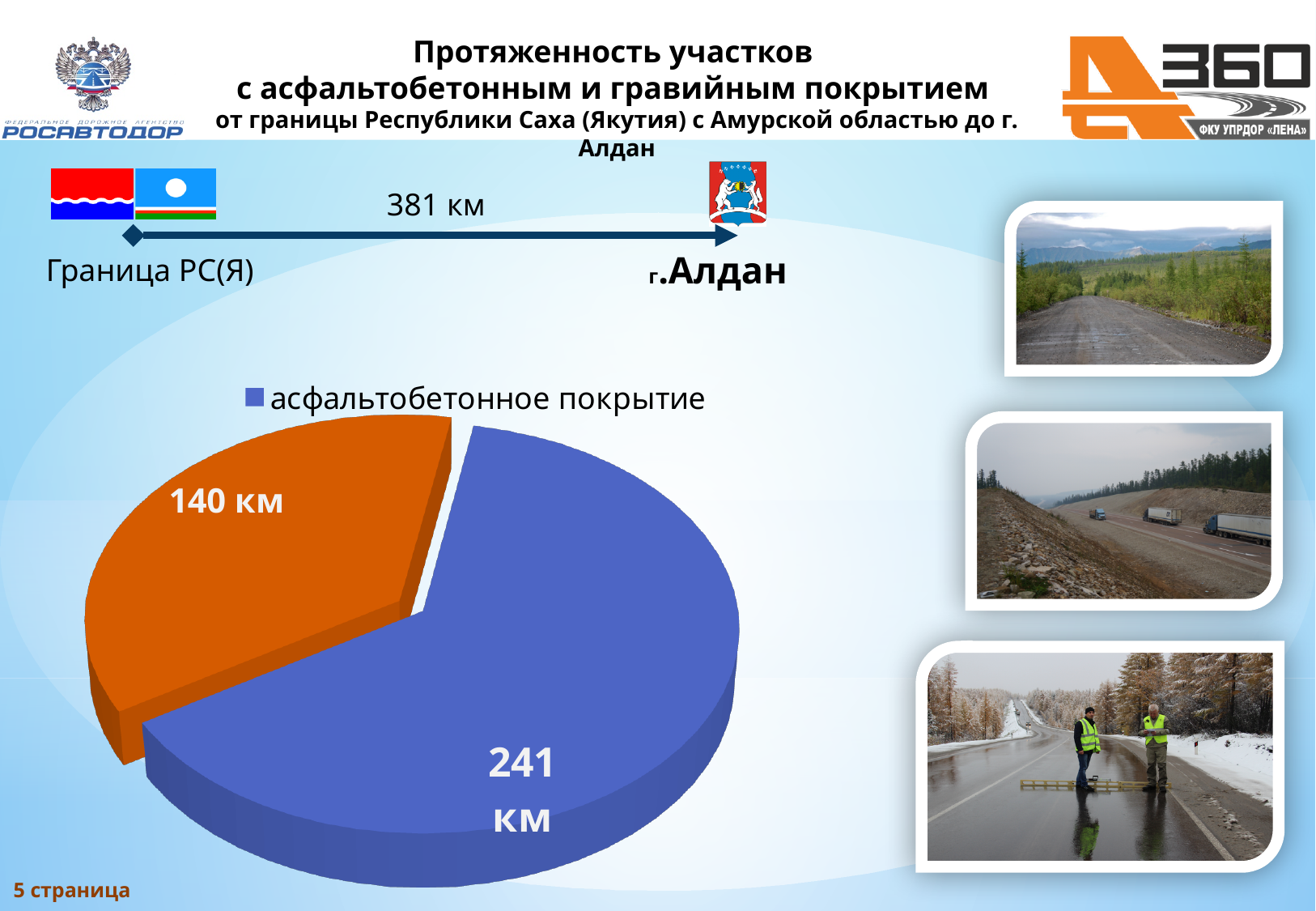
How many entries does the legend of the pie chart list? 1 Which is larger in the pie chart: the blue slice or the orange slice? the blue slice Which slice of the pie chart is the smallest? the orange slice (140 км) What is the legend entry shown above the pie chart? асфальтобетонное покрытие How many slices does the pie chart have? 2 What is the value of the асфальтобетонное покрытие slice in the pie chart? 241 км What is the difference between the two slices of the pie chart? 101 км What is the value of the orange slice in the pie chart? 140 км Which slice of the pie chart is the largest? асфальтобетонное покрытие What kind of chart is shown on the slide? pie chart What is the total length of the two slices in the pie chart? 381 км What colour is the асфальтобетонное покрытие slice in the pie chart? blue